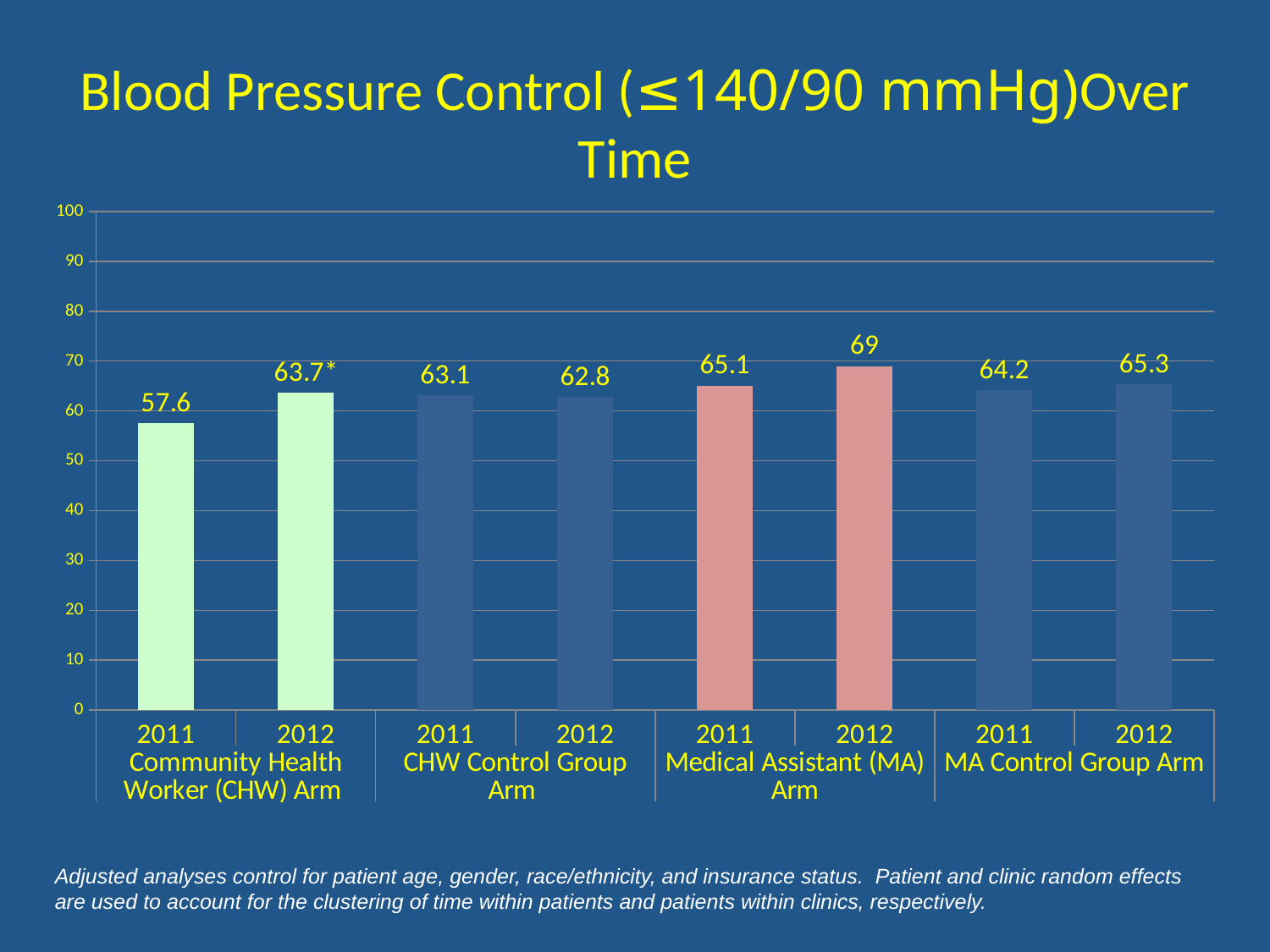
Does the value in the CHW Control Group Arm rise or fall from 2011 to 2012? Fall Which bar has the lowest value on the chart? 2011 Community Health Worker (CHW) Arm What type of chart is shown on the slide? Bar chart Which is larger: the 2012 value for the MA Control Group Arm or the 2012 value for the CHW Control Group Arm? MA Control Group Arm What is the difference between the 2012 and 2011 values in the Community Health Worker (CHW) Arm? 6.1 What is the value for 2012 in the CHW Control Group Arm? 62.8 How many bars are plotted on the chart? 8 What is the title of the chart? Blood Pressure Control (≤140/90 mmHg) Over Time Which bar has the highest value on the chart? 2012 Medical Assistant (MA) Arm What is the value for 2011 in the MA Control Group Arm? 64.2 What is the value for 2012 in the Medical Assistant (MA) Arm? 69 What is the value for 2011 in the Community Health Worker (CHW) Arm? 57.6